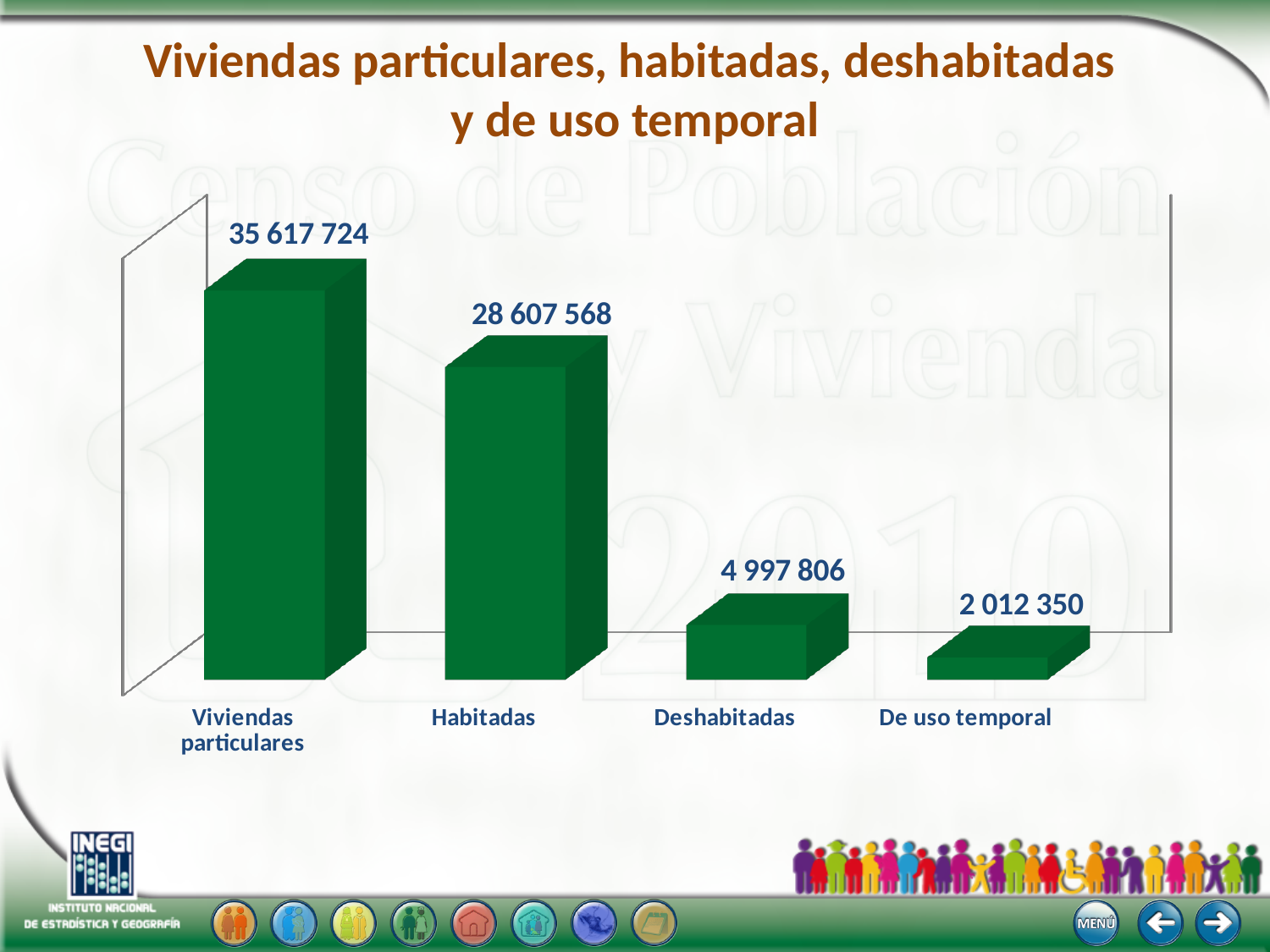
Which category has the highest value? Viviendas particulares Which is larger, the value for Habitadas or the value for Deshabitadas? Habitadas What is the title of the chart? Viviendas particulares, habitadas, deshabitadas y de uso temporal How many categories are shown in the chart? 4 What is the value for Deshabitadas? 4 997 806 What is the value for Habitadas? 28 607 568 What kind of chart is shown on the slide? Bar chart What is the value for Viviendas particulares? 35 617 724 What is the difference between the values for Deshabitadas and De uso temporal? 2 985 456 Which category has the lowest value? De uso temporal What is the value for De uso temporal? 2 012 350 What is the difference between the values for Viviendas particulares and Habitadas? 7 010 156